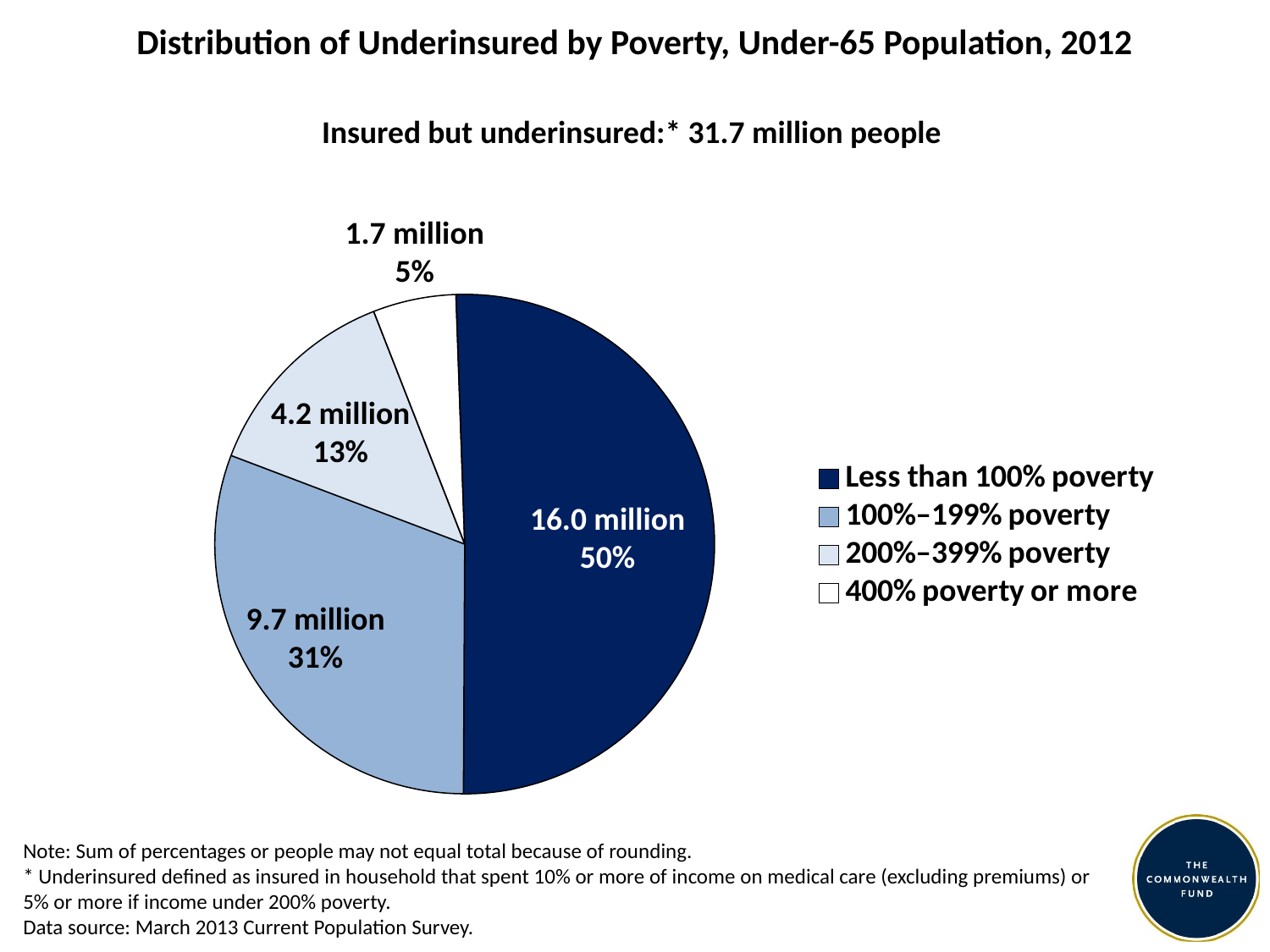
Which poverty group has the largest share of the underinsured? Less than 100% poverty What share of the pie is the '400% poverty or more' slice? 5% Which group is larger: '200%–399% poverty' or '400% poverty or more'? 200%–399% poverty How many slices does the pie chart have? 4 How many people are in the '200%–399% poverty' slice? 4.2 million What percentage of the underinsured are in the '100%–199% poverty' group? 31% Which poverty group has the smallest share of the underinsured? 400% poverty or more What is the difference in millions of people between the 'Less than 100% poverty' and '100%–199% poverty' groups? 6.3 million What is the total number of insured but underinsured people stated on the slide? 31.7 million people What type of chart is shown on the slide? pie chart How many people are in the 'Less than 100% poverty' slice? 16.0 million What is the title of the chart? Distribution of Underinsured by Poverty, Under-65 Population, 2012